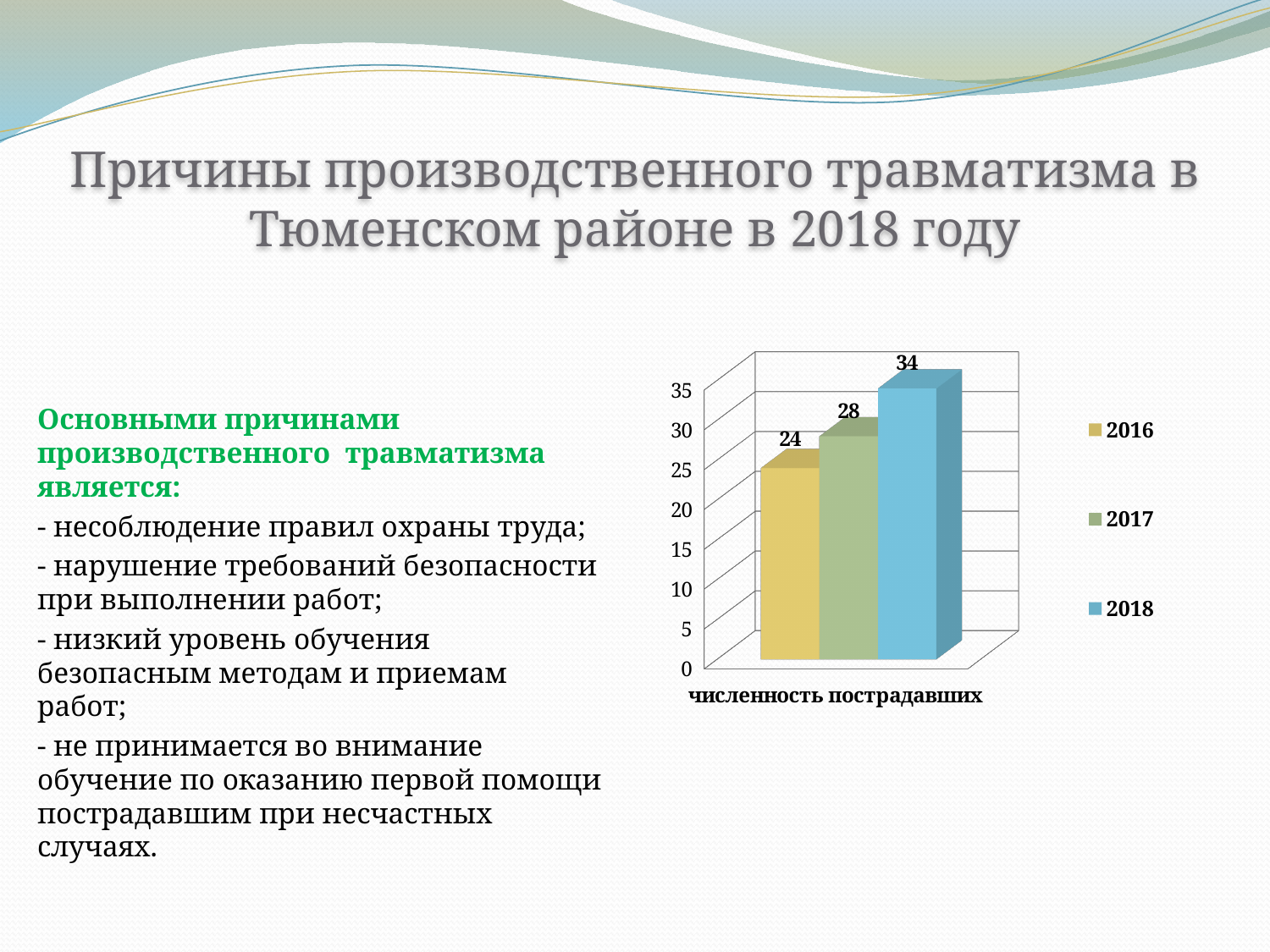
Is the value for 2018 greater or less than 30? greater Which year has the lowest value in the chart? 2016 Which year has the highest value in the chart? 2018 What is the value for 2018 in the chart? 34 How many series does the legend list? 3 What is the category label shown below the bars? численность пострадавших Which is larger, the value for 2017 or the value for 2018? 2018 What is the value for 2016 in the chart? 24 What kind of chart is shown on the slide? bar chart What is the difference between the values for 2018 and 2016? 10 What is the difference between the values for 2017 and 2016? 4 What is the value for 2017 in the chart? 28